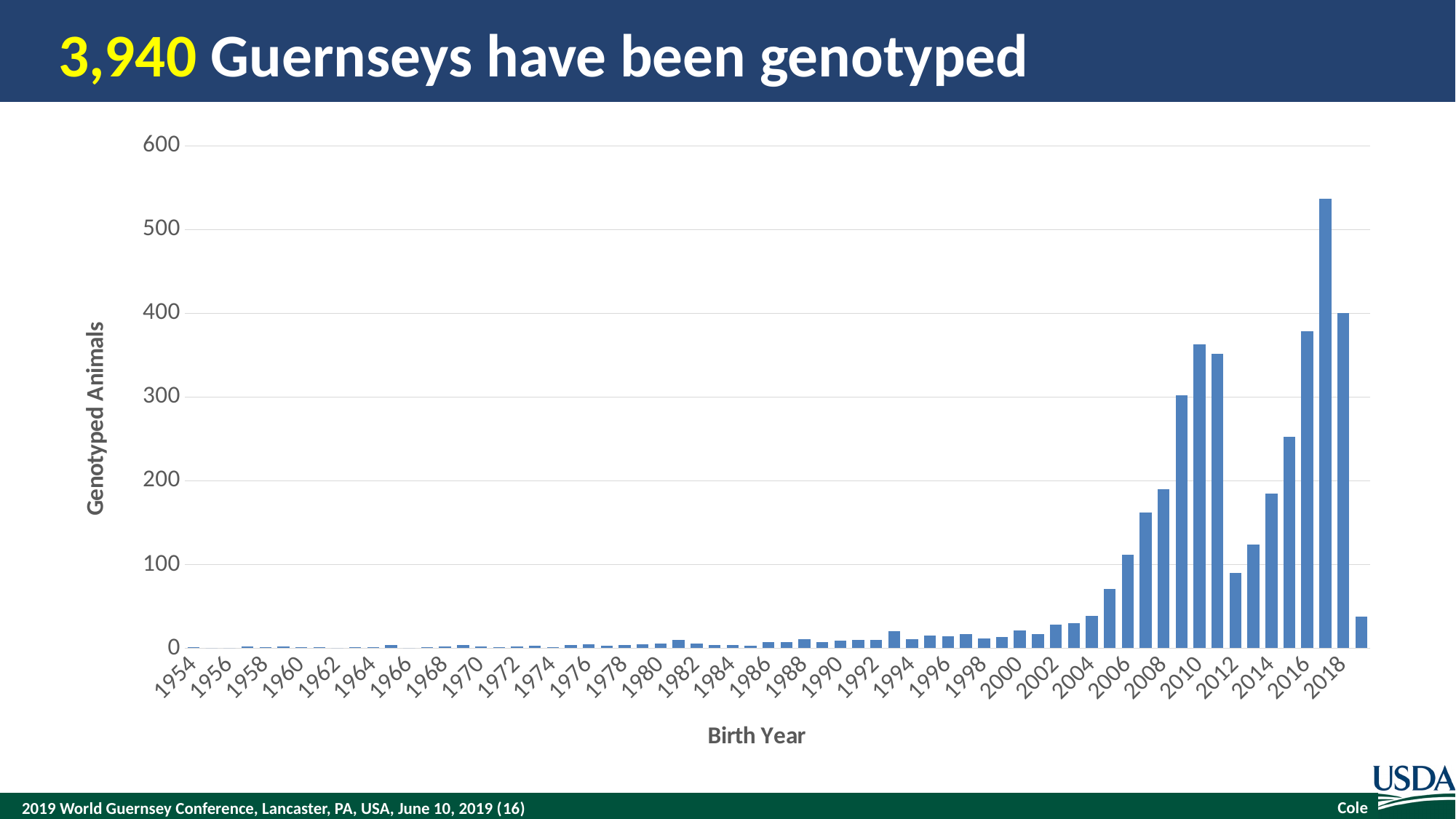
Is the value for birth year 2012 greater or less than 100? less Do the values rise or fall from birth year 2012 to birth year 2017? rise Which birth year has more genotyped animals, 2010 or 2012? 2010 Is the value for birth year 2005 greater or less than 100? less Is the value for birth year 2017 greater or less than 500? greater Which birth year has the highest number of genotyped animals? 2017 What is the label of the vertical axis? Genotyped Animals Which birth year has more genotyped animals, 2017 or 2018? 2017 What kind of chart is shown on the slide? bar chart